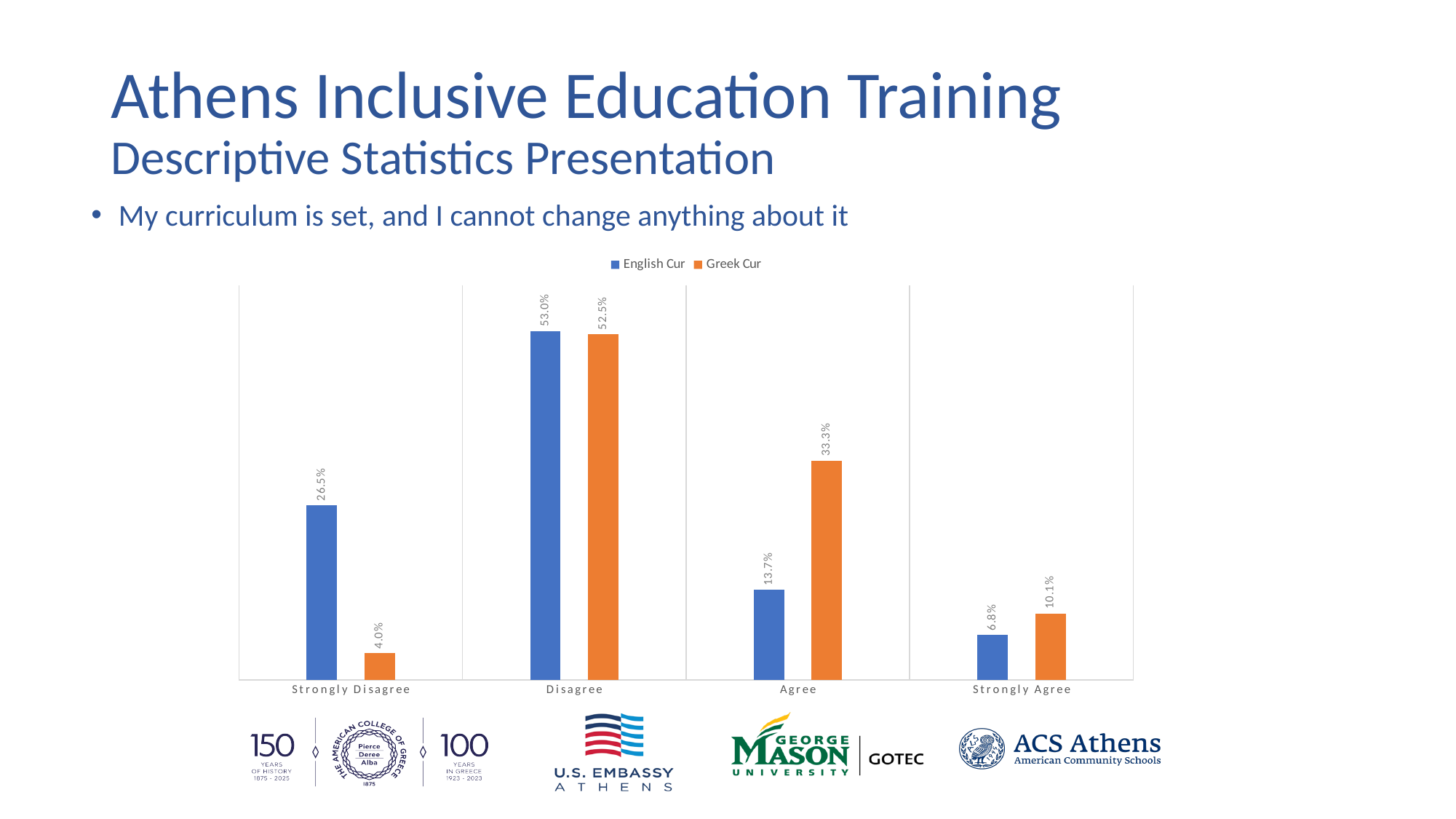
How many categories are shown on the x axis? 4 Which category has the highest English Cur value? Disagree What is the Greek Cur value for Agree? 33.3% Which colour represents the Greek Cur series? Orange What is the Greek Cur value for Strongly Disagree? 4.0% Which category has the lowest Greek Cur value? Strongly Disagree What is the English Cur value for Strongly Disagree? 26.5% What is the difference between the English Cur and Greek Cur values for Disagree? 0.5% What kind of chart is shown on the slide? Bar chart How many series does the legend list? 2 What is the English Cur value for Strongly Agree? 6.8% Which is larger for Agree: the English Cur value or the Greek Cur value? Greek Cur